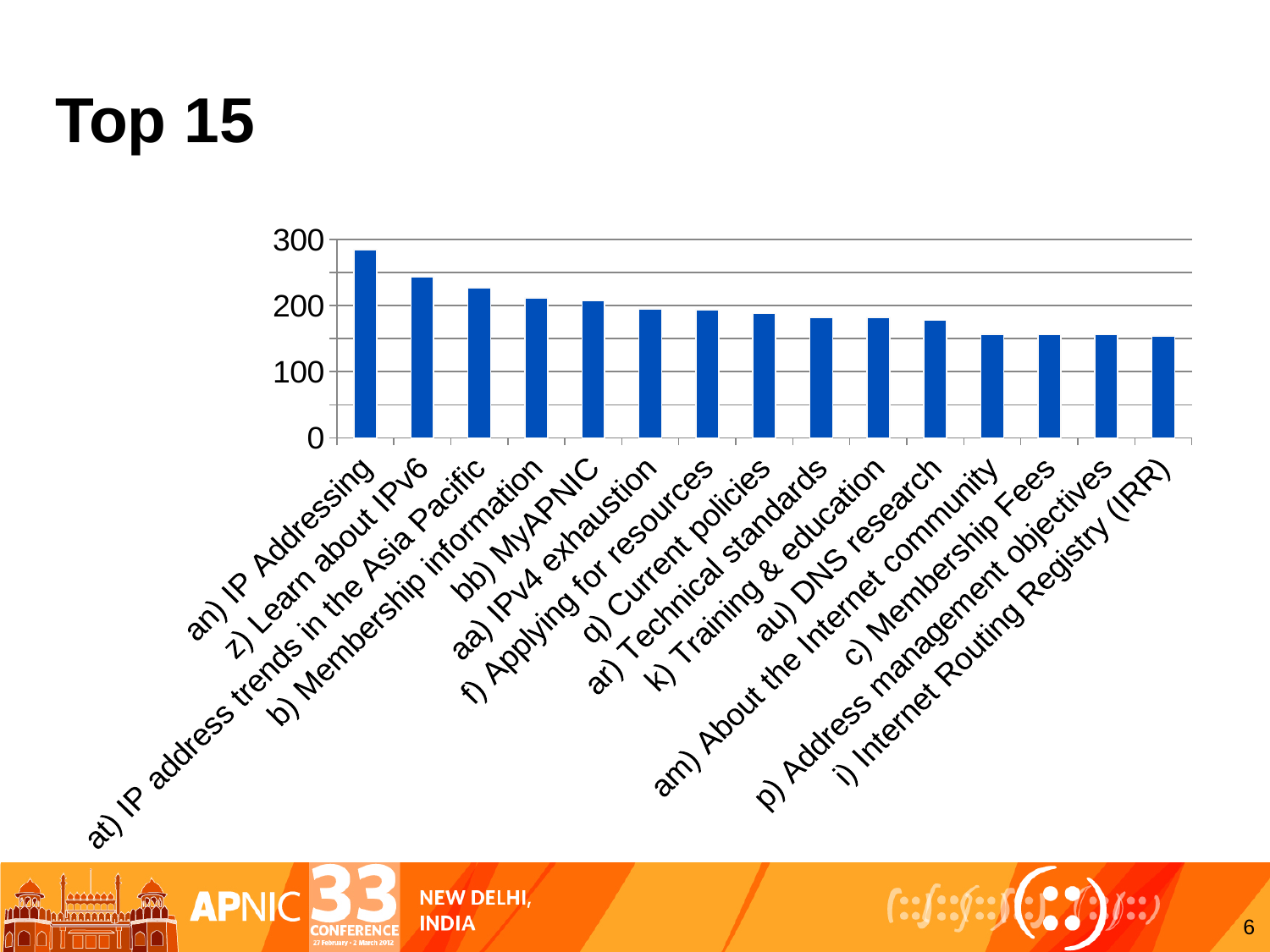
Which is larger, the value for z) Learn about IPv6 or the value for c) Membership Fees? z) Learn about IPv6 Is the value for z) Learn about IPv6 greater or less than 200? greater What is the title of the slide containing the chart? Top 15 Which is larger, the value for an) IP Addressing or the value for z) Learn about IPv6? an) IP Addressing Is the value for i) Internet Routing Registry (IRR) greater or less than 100? greater Is the value for an) IP Addressing greater or less than 300? less How many categories are plotted in the chart? 15 Which category has the highest value in the chart? an) IP Addressing What kind of chart is shown on the slide? bar chart Do the bar values rise or fall from left to right along the x axis? fall